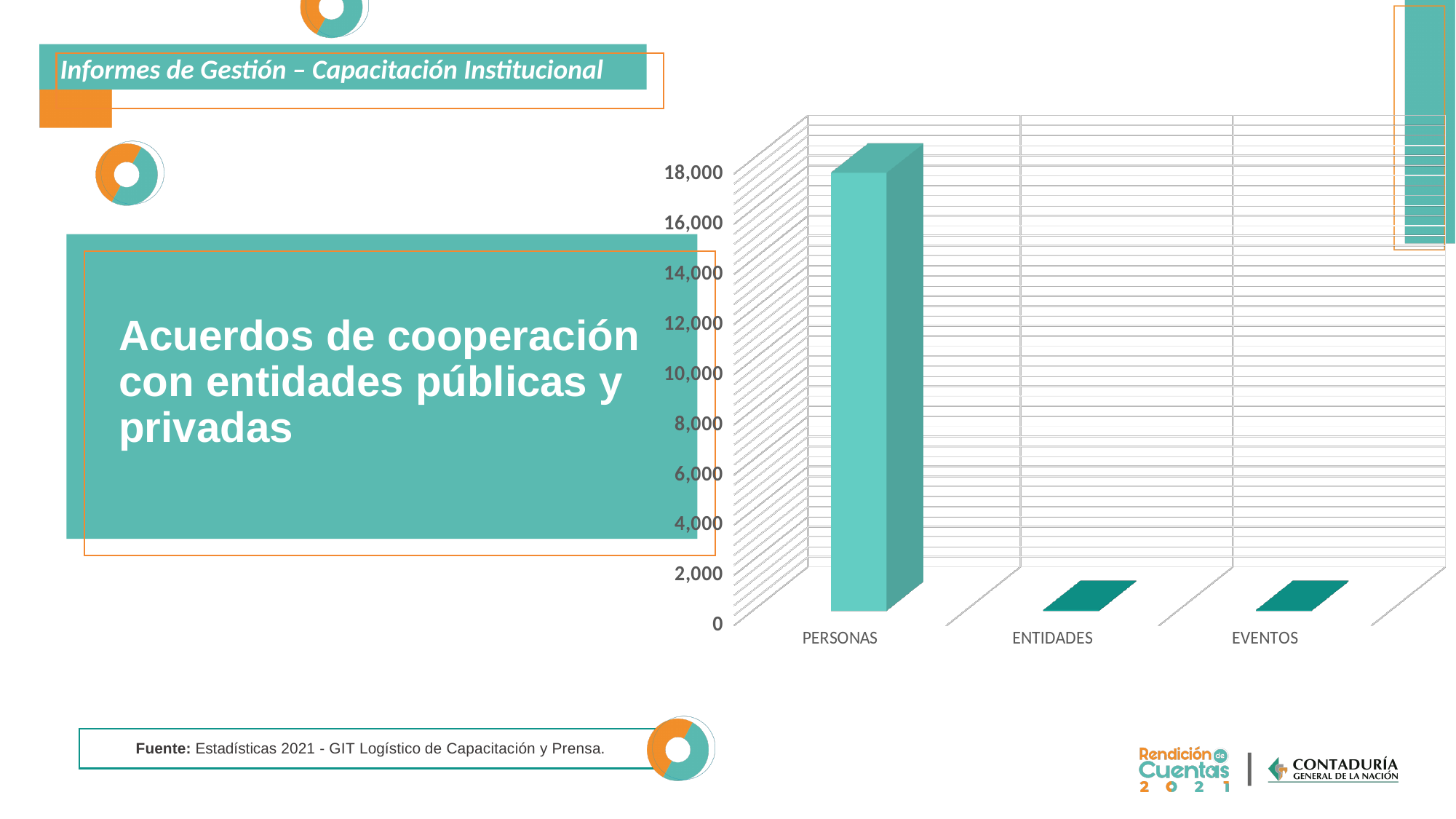
Which is larger, the value for PERSONAS or the value for ENTIDADES? PERSONAS Which category has the highest value in the chart? PERSONAS How many categories are shown on the x axis of the chart? 3 Is the value for EVENTOS greater or less than 2,000? less Is the value for ENTIDADES greater or less than 2,000? less Is the value for PERSONAS greater or less than 14,000? greater Which is larger, the value for EVENTOS or the value for PERSONAS? PERSONAS What is the highest tick value shown on the vertical axis of the chart? 18,000 What is the label of the first category on the x axis of the chart? PERSONAS What kind of chart is shown on the slide? bar chart